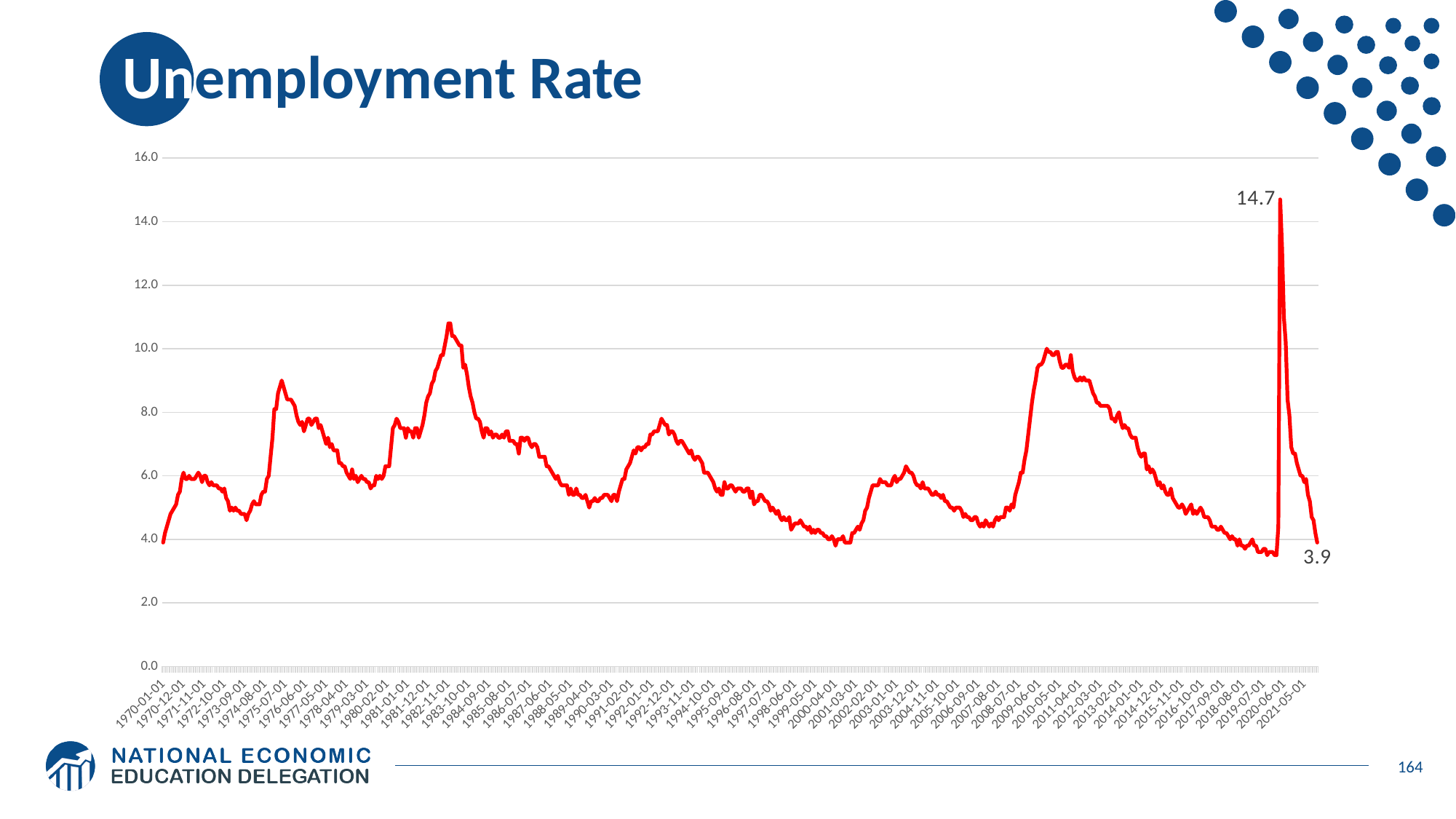
What is the difference between the labeled peak value of 14.7 and the final labeled value of 3.9? 10.8 What is the unemployment rate value labeled at the end of the series (2021)? 3.9 Which peak is higher: the one around 1975 or the one around 1982-1983? 1982-1983 What kind of chart is shown on the slide? line chart Is the unemployment rate at its peak around 1982-1983 greater or less than 10.0? greater Is the unemployment rate at its peak around 2009-2010 greater or less than 8.0? greater What colour is the line plotted on the chart? red Is the labeled peak value of 14.7 greater or less than 12.0? greater Between 2010 and 2019, does the unemployment rate generally rise or fall? fall What is the title of the slide? Unemployment Rate What is the highest unemployment rate value labeled on the chart? 14.7